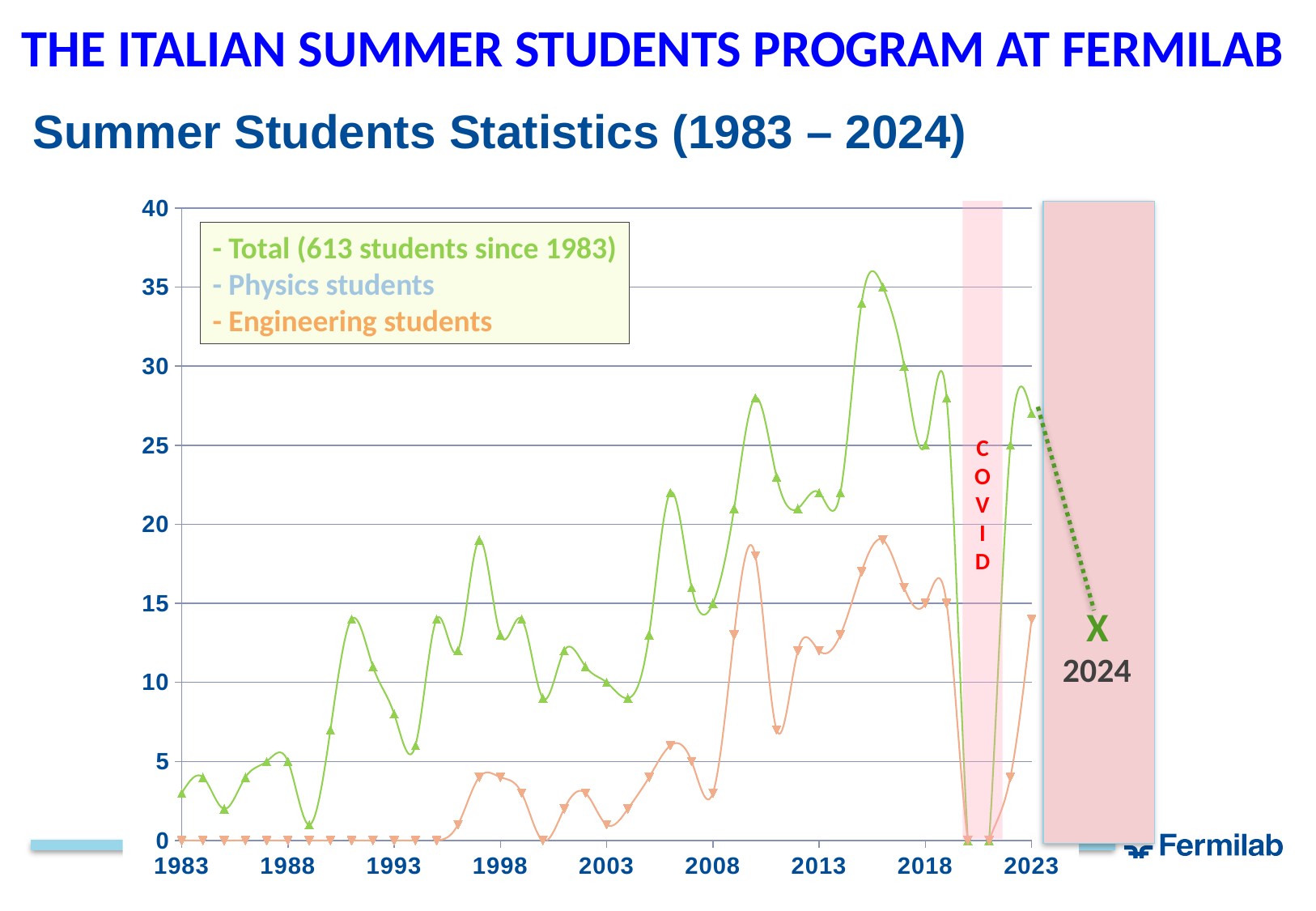
What value does the Total series drop to during the COVID years? 0 What is the title of the chart? Summer Students Statistics (1983 – 2024) In 2013, which series has the larger value, Total or Engineering students? Total Is the value of the Total series in 2023 greater or less than 25? greater What kind of chart is shown on the slide? line chart Is the value of the Engineering students series in 2008 greater or less than 5? less Is the value of the Total series in 2013 greater or less than 20? greater How many series does the legend list? 3 What is the value of the Engineering students series in 1983? 0 Does the Engineering students series rise or stay flat between 1983 and 1993? stays flat According to the legend, how many students in total have taken part since 1983? 613